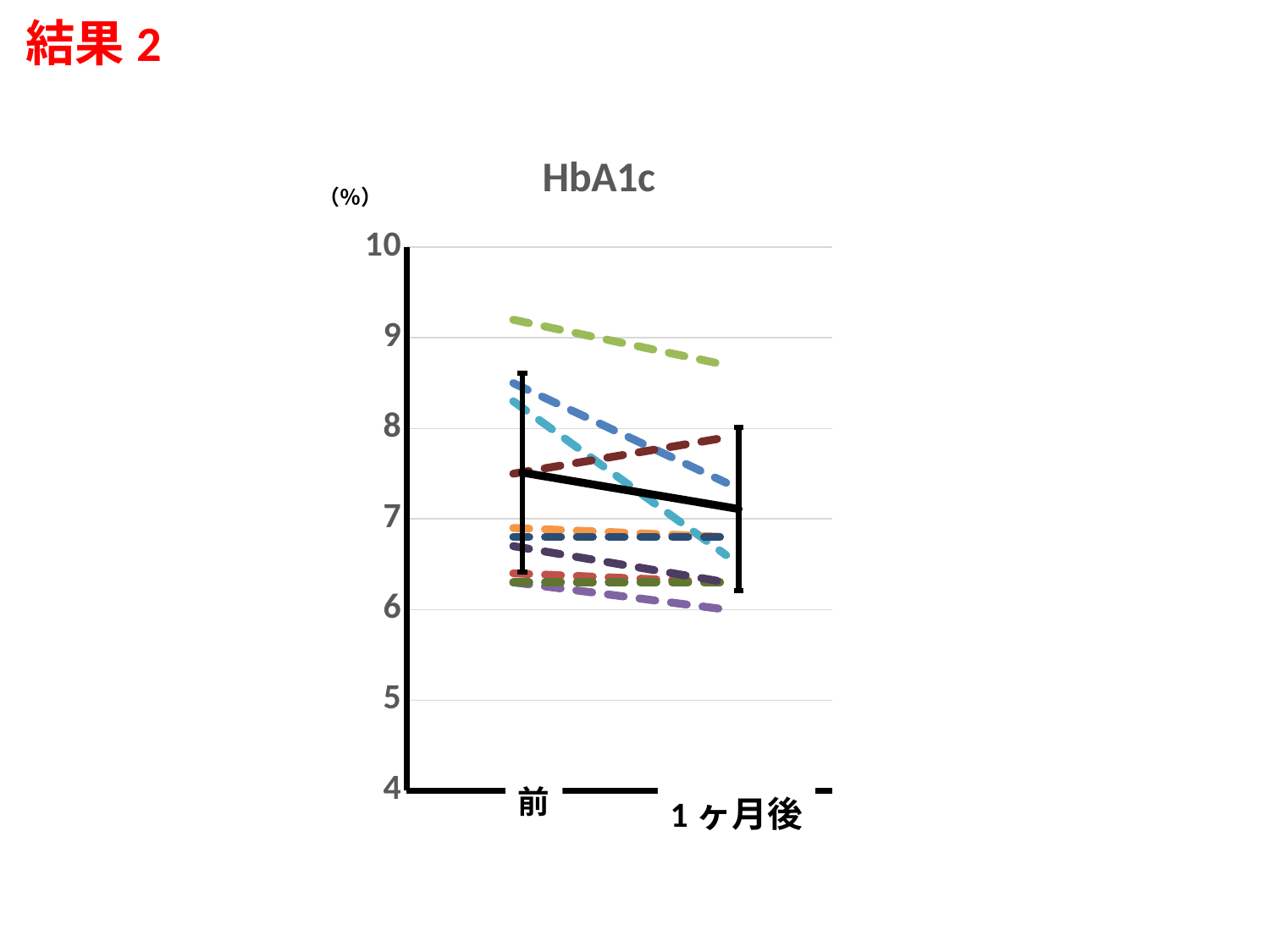
Is the value of the light blue dashed line at 1ヶ月後 greater or less than 7? less How many categories are shown on the x axis of the chart? 2 Does the dark red dashed line rise or fall from 前 to 1ヶ月後? rise Is the value of the solid black line at 前 greater or less than 7? greater What kind of chart is shown on the slide? line chart Does the light green dashed line rise or fall from 前 to 1ヶ月後? fall Does the solid black line rise or fall from 前 to 1ヶ月後? fall Is the value of the light green dashed line at 前 greater or less than 9? greater What unit is shown on the y axis of the chart? (%) Which line has the highest value at 前, the light green dashed line or the solid black line? the light green dashed line What is the title of the chart? HbA1c